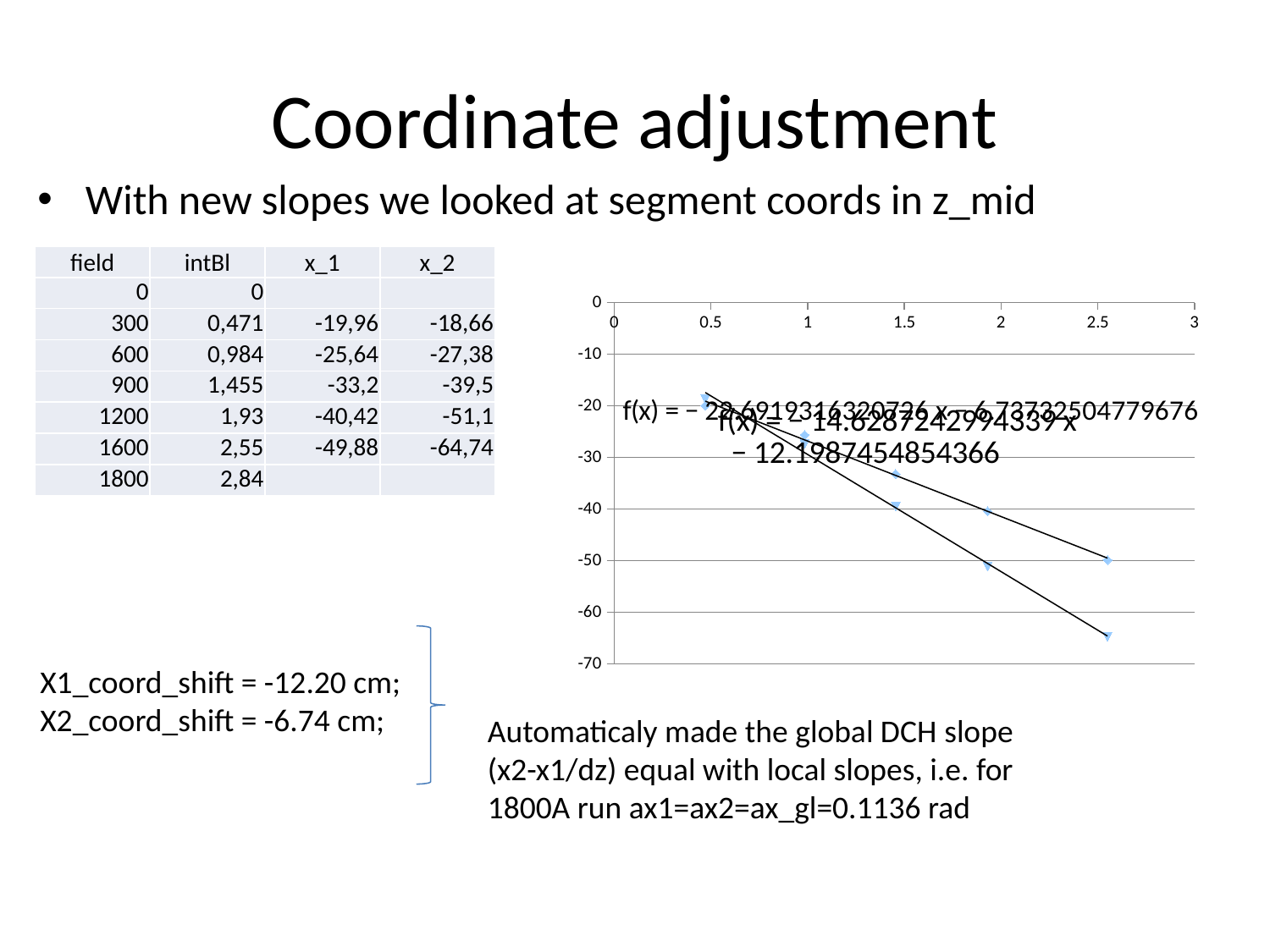
Is the upper series point at x about 1 greater or less than -30? greater How many trendlines are drawn on the chart? 2 What kind of chart is shown on the slide? scatter chart Is the upper series point at x about 2 greater or less than -50? greater Do the plotted values rise or fall as the x value increases? fall Is the lowest plotted point (at x about 2.55) greater or less than -60? less How many points does each of the two plotted series have? 5 What is the slope in the trendline equation f(x) = −14.6287242994339 x − 12.1987454854366 shown on the chart? -14.6287242994339 What is the minimum value shown on the chart's y axis? -70 What is the maximum value shown on the chart's x axis? 3 How many data points are plotted in the chart in total? 10